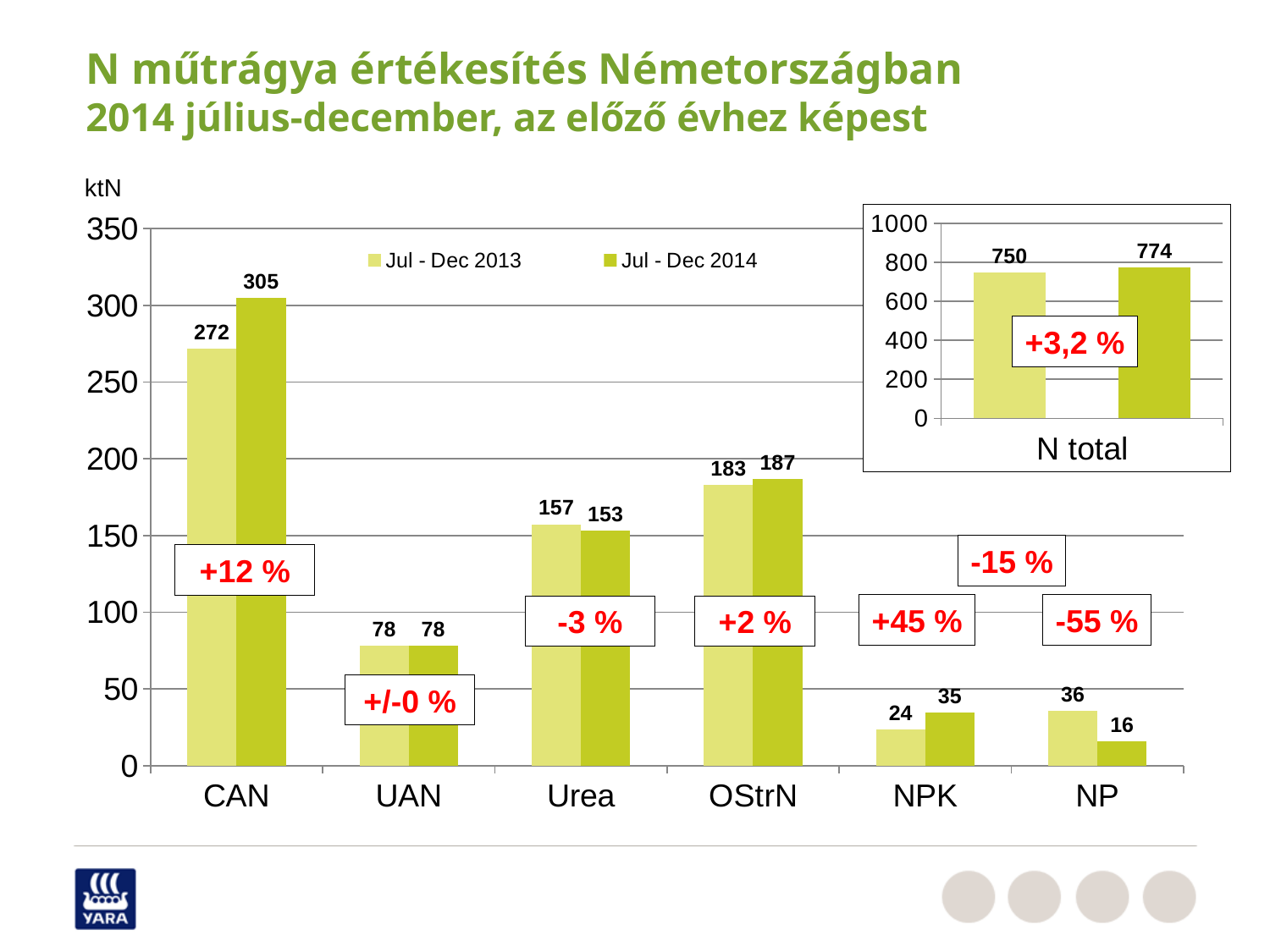
In the main chart, which is larger for NPK: the Jul - Dec 2013 value or the Jul - Dec 2014 value? Jul - Dec 2014 What percentage change is printed in the inset 'N total' chart? +3,2 % In the main chart, which category has the lowest Jul - Dec 2014 value? NP In the main chart, which category has the highest Jul - Dec 2014 value? CAN How many series does the legend of the main chart list? 2 How many categories are shown on the x axis of the main chart? 6 In the inset 'N total' chart, what is the difference between the 2014 and 2013 values? 24 In the main chart, what is the Jul - Dec 2014 value for CAN? 305 What kind of chart is the main chart? bar chart In the main chart, what is the difference between the Jul - Dec 2014 and Jul - Dec 2013 values for CAN? 33 In the main chart, what is the Jul - Dec 2013 value for Urea? 157 In the inset 'N total' chart, what is the Jul - Dec 2014 value? 774